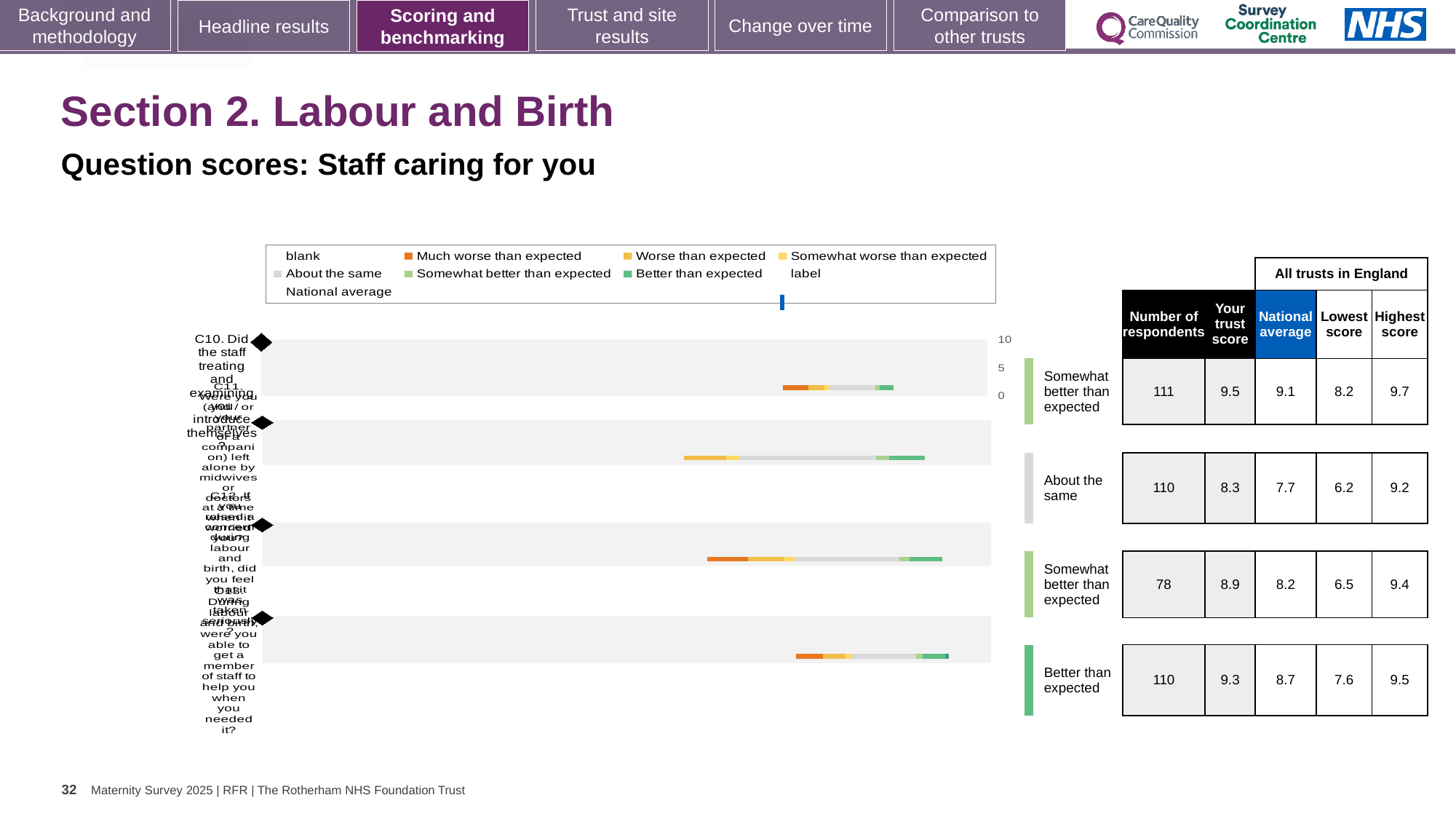
In the table beside the chart, what is the highest score for the fourth row (Better than expected)? 9.5 In the table beside the chart, what is the 'Your trust score' for the first row? 9.5 What colour does the legend use for 'Much worse than expected'? orange What kind of chart is shown on the slide? bar chart How many question rows (categories) are plotted in the chart? 4 What is the difference between the trust score and the national average in the first row of the table? 0.4 In the third row of the table, which is larger: the trust score or the national average? the trust score (8.9) Which row in the table has the highest 'Your trust score'? the first row (9.5) Which row in the table has the lowest number of respondents? the third row (78) In the table beside the chart, how many respondents are recorded for the third row? 78 What is the subtitle describing the chart's content? Question scores: Staff caring for you In the table beside the chart, what is the national average for the second row (About the same)? 7.7